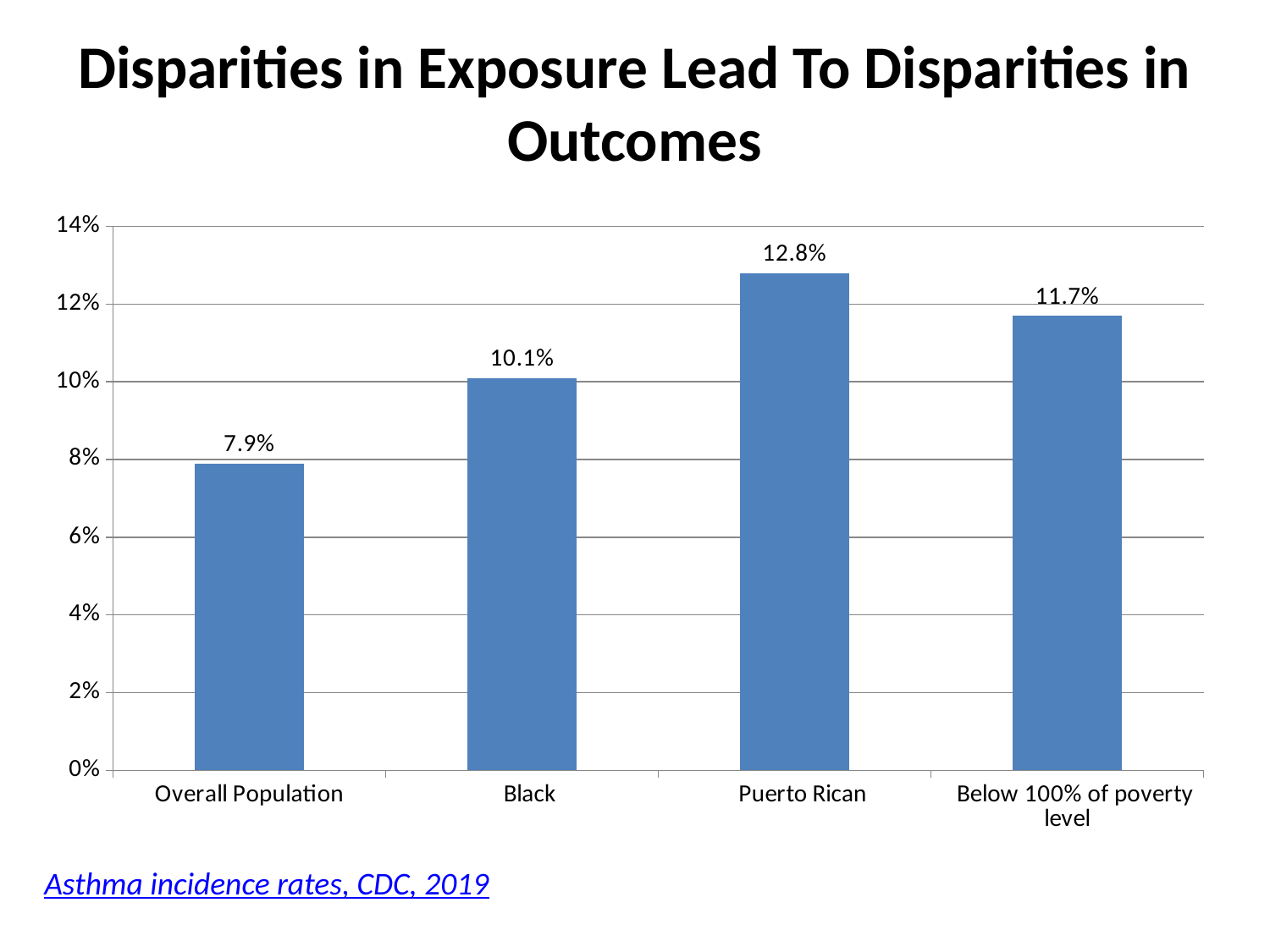
Which category has the lowest value? Overall Population What is the difference between the values for Below 100% of poverty level and Black? 1.6% What is the value for Overall Population? 7.9% Is the value for Black greater or less than 8%? greater Which category has the highest value? Puerto Rican What is the value for Black? 10.1% What is the value for Puerto Rican? 12.8% How many categories are shown in the chart? 4 What is the value for Below 100% of poverty level? 11.7% What is the difference between the values for Puerto Rican and Overall Population? 4.9% What kind of chart is shown on the slide? Bar chart Which is larger, the value for Black or the value for Below 100% of poverty level? Below 100% of poverty level